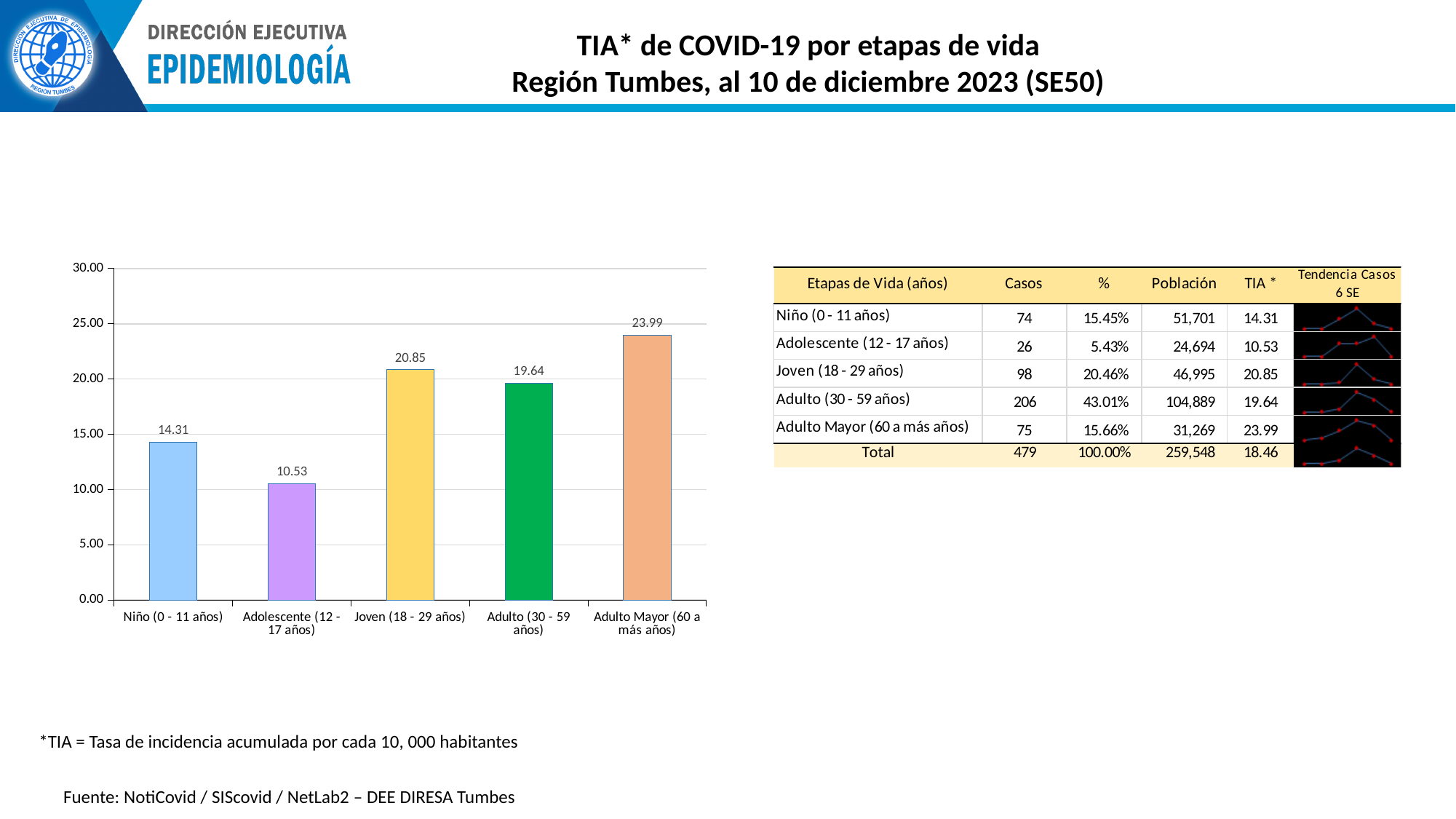
What is the TIA value shown for Niño (0 - 11 años) in the bar chart? 14.31 What is the TIA value shown for Adolescente (12 - 17 años) in the bar chart? 10.53 Which life stage has the lowest TIA in the bar chart? Adolescente (12 - 17 años) What is the TIA value shown for Joven (18 - 29 años) in the bar chart? 20.85 Is the TIA value for Adulto Mayor (60 a más años) greater or less than 20.00 in the bar chart? greater Which life stage has the highest TIA in the bar chart? Adulto Mayor (60 a más años) How many life-stage categories are shown in the bar chart? 5 What is the difference between the TIA for Adulto Mayor (60 a más años) and Niño (0 - 11 años) in the bar chart? 9.68 What colour is the bar for Adulto (30 - 59 años) in the bar chart? Green What is the TIA value shown for Adulto (30 - 59 años) in the bar chart? 19.64 Which has a higher TIA in the bar chart, Joven (18 - 29 años) or Adulto (30 - 59 años)? Joven (18 - 29 años) What type of chart is used to show TIA by life stage? Bar chart